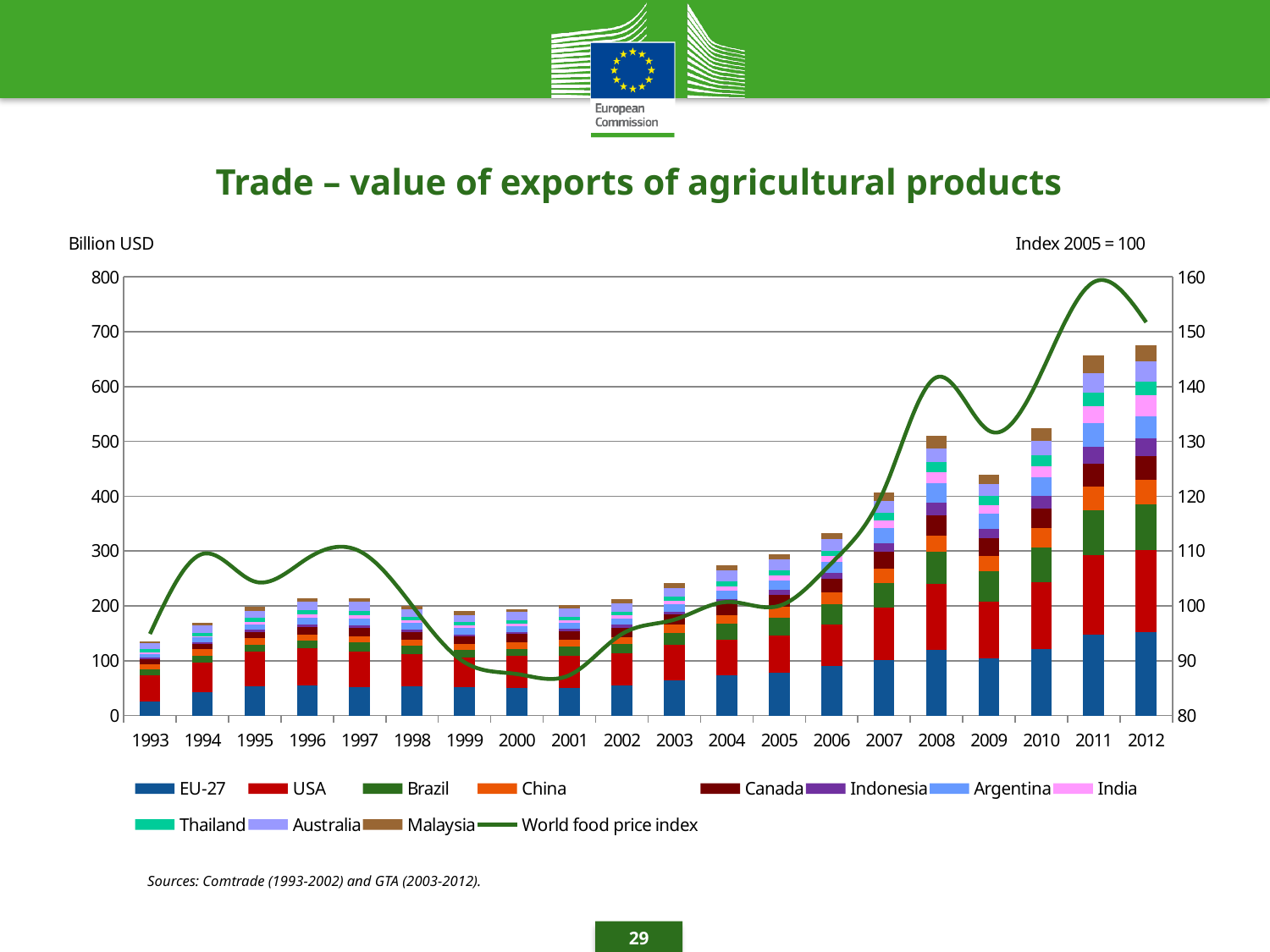
Does the total value of agricultural exports generally rise or fall from 1993 to 2012? rise Which series is plotted as a line rather than as stacked bars? World food price index Which year has the lowest total value of agricultural exports (shortest stacked bar)? 1993 Which year has the highest total value of agricultural exports (tallest stacked bar)? 2012 Is the total stacked bar for 2012 greater or less than 600 billion USD? greater Which year has a larger total value of exports, 2010 or 2009? 2010 How many series does the legend list? 12 Is the World food price index in 2011 greater or less than 150? greater Is the total stacked bar for 1993 greater or less than 200 billion USD? less What kind of chart is shown on the slide? stacked bar chart with a line How many years are shown along the x axis? 20